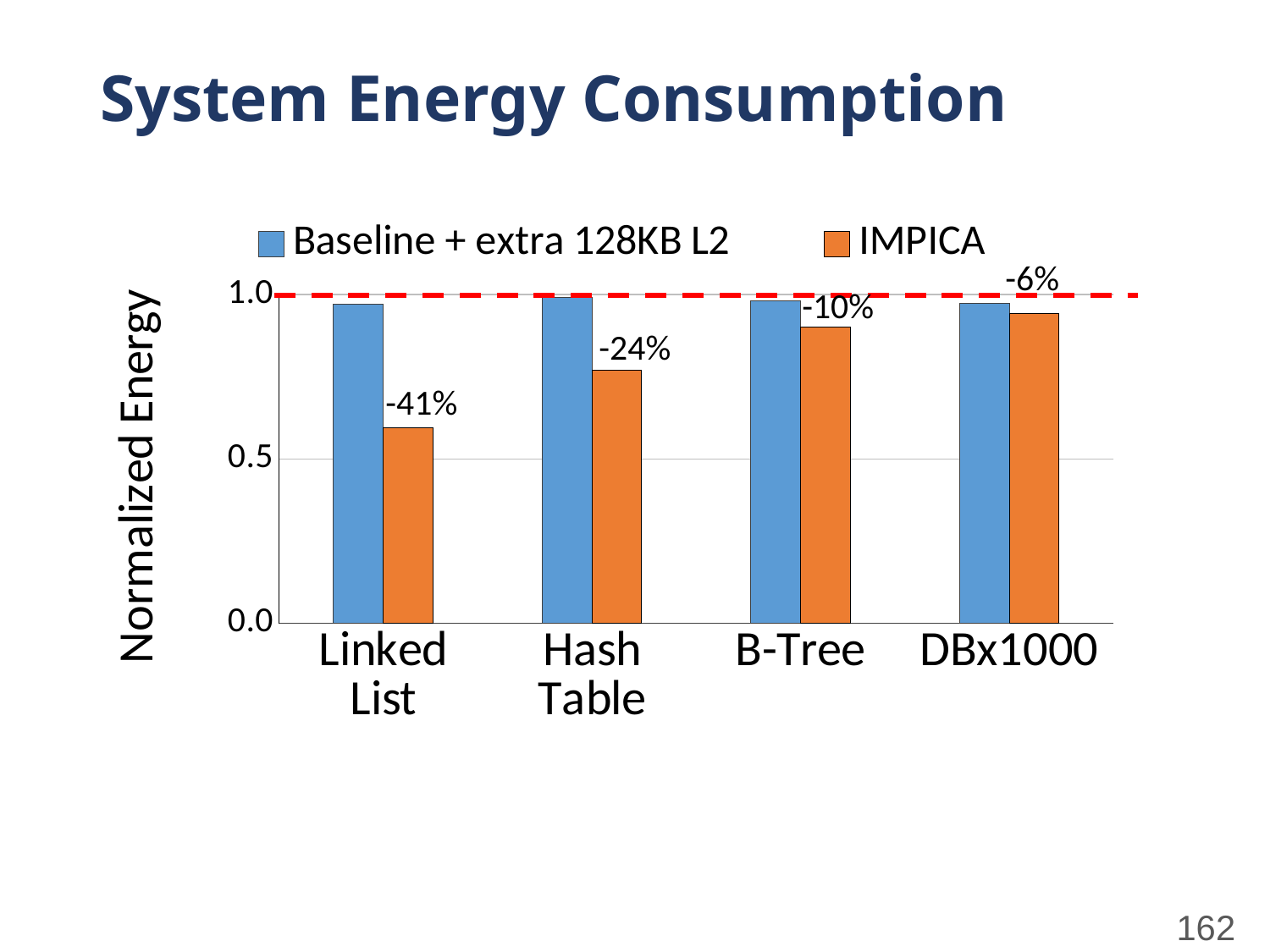
What percentage reduction is labeled above the IMPICA bar for B-Tree? -10% Is the IMPICA value for Hash Table greater or less than 0.5? greater What percentage reduction is labeled above the IMPICA bar for DBx1000? -6% What percentage reduction is labeled above the IMPICA bar for Linked List? -41% How many series does the legend list? 2 Which category has the lowest IMPICA normalized energy? Linked List How many categories are shown on the x axis? 4 For Linked List, which is larger: the Baseline + extra 128KB L2 bar or the IMPICA bar? Baseline + extra 128KB L2 What is the label of the y axis? Normalized Energy What kind of chart is shown on the slide? bar chart What percentage reduction is labeled above the IMPICA bar for Hash Table? -24% Which category has the highest IMPICA normalized energy? DBx1000